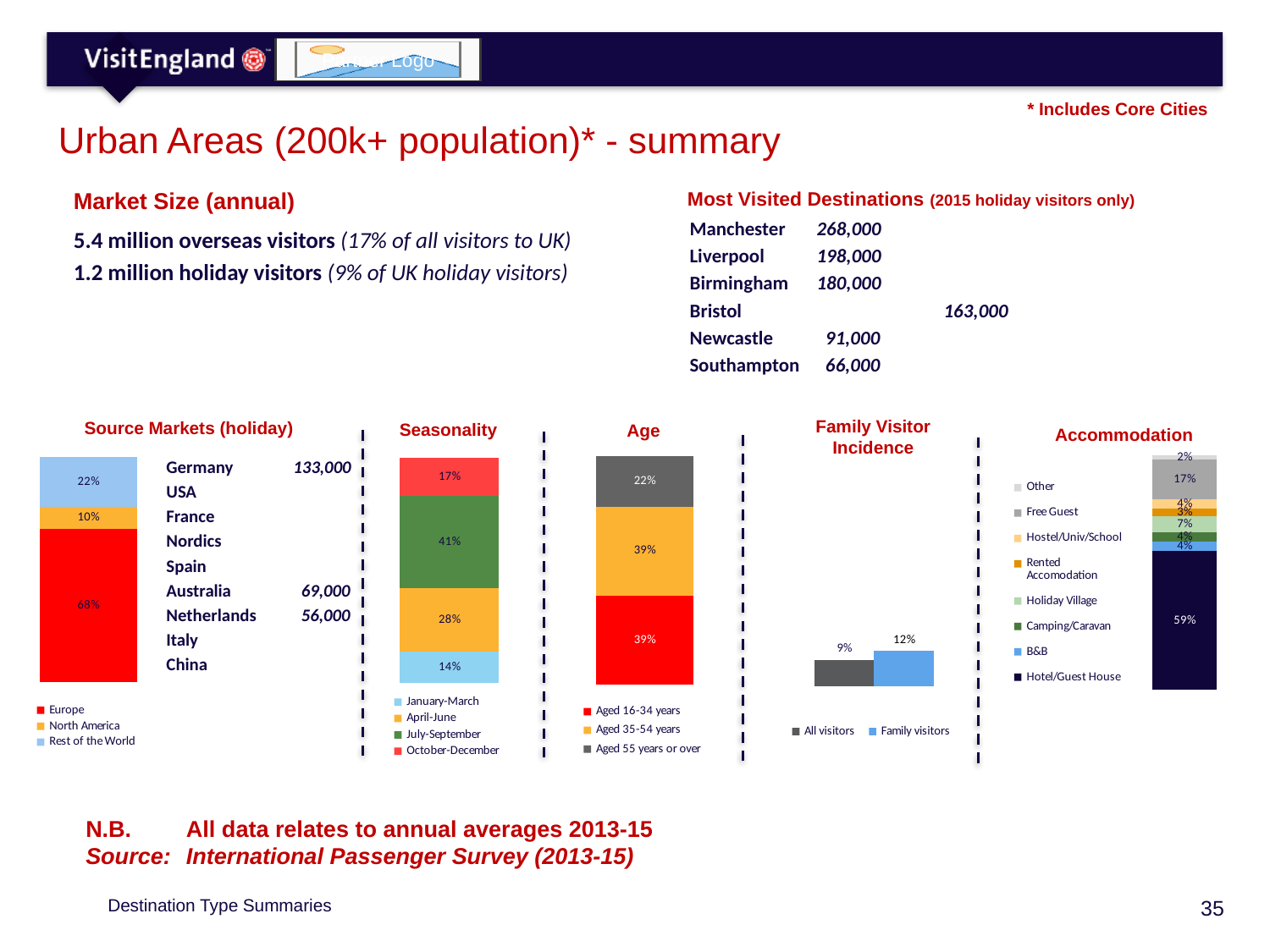
In the Source Markets (holiday) chart, which source market has the largest share? Europe In the Family Visitor Incidence chart, what is the value for Family visitors? 12% In the Seasonality chart, what percentage of visits occur in July-September? 41% In the Age chart, what percentage of visitors are aged 55 years or over? 22% How many age groups does the legend of the Age chart list? 3 In the Accommodation chart, what share of visitors stay in a Hotel/Guest House? 59% In the Source Markets (holiday) chart, what share of holiday visitors come from North America? 10% In the Seasonality chart, which period has the smallest share of visits? January-March What type of chart is the Seasonality chart? Stacked bar chart In the Seasonality chart, what is the difference between the July-September share and the April-June share? 13 percentage points In the Source Markets (holiday) chart, what share of holiday visitors come from Europe? 68% In the Family Visitor Incidence chart, which is larger, All visitors or Family visitors? Family visitors